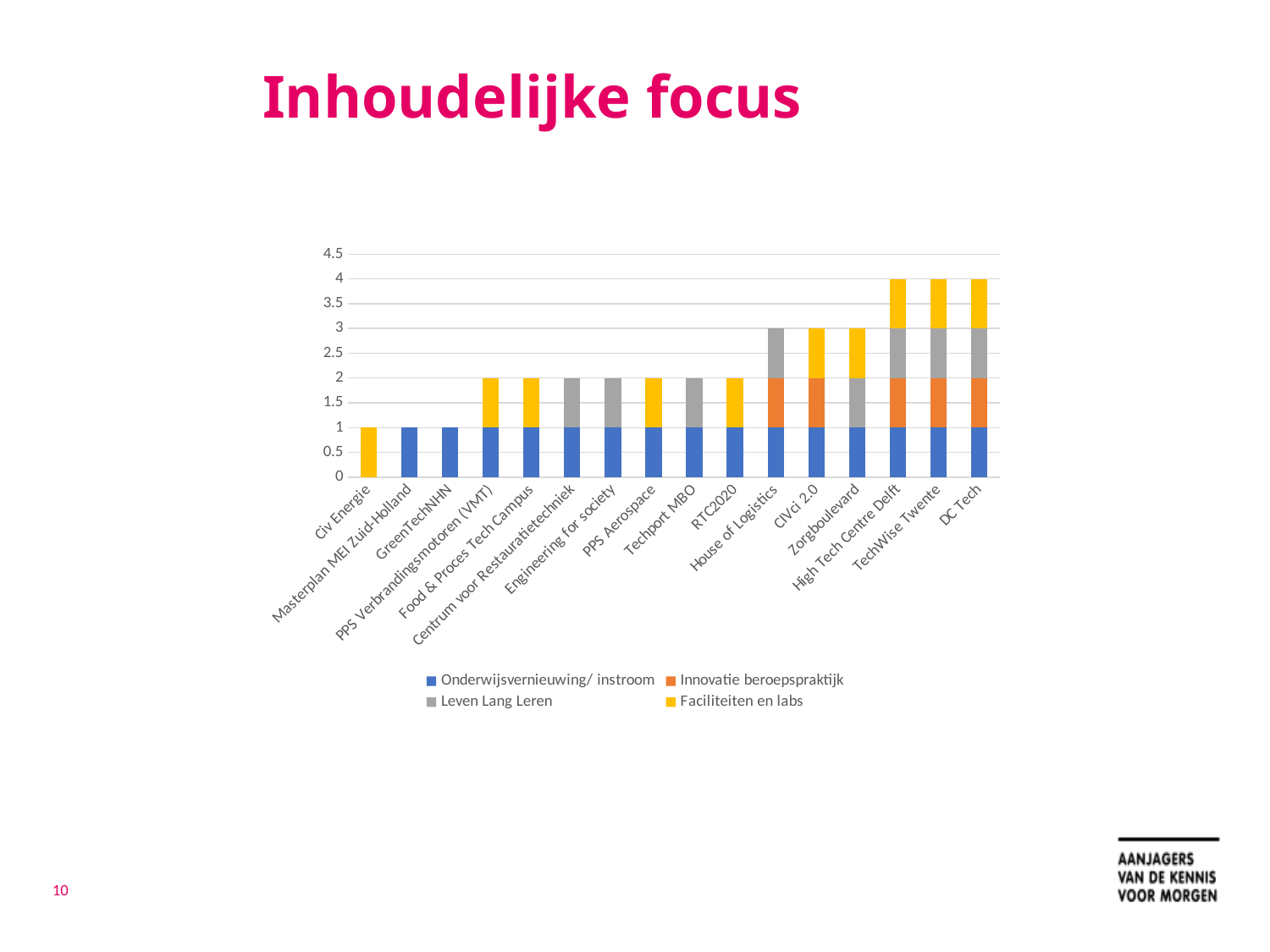
What kind of chart is shown on the slide? stacked bar chart Do the bar totals generally rise or fall from left to right along the x axis? rise What is the title of the slide containing the chart? Inhoudelijke focus Is the total for GreenTechNHN greater or less than 2? less What is the total height of the stacked bar for DC Tech? 4 Which is larger, the total for Zorgboulevard or the total for RTC2020? Zorgboulevard What is the total height of the stacked bar for House of Logistics? 3 How many categories are shown on the x axis? 16 How many series does the legend list? 4 Is the total for TechWise Twente greater or less than 3? greater Which legend entry is shown in yellow? Faciliteiten en labs What is the total height of the stacked bar for Civ Energie? 1